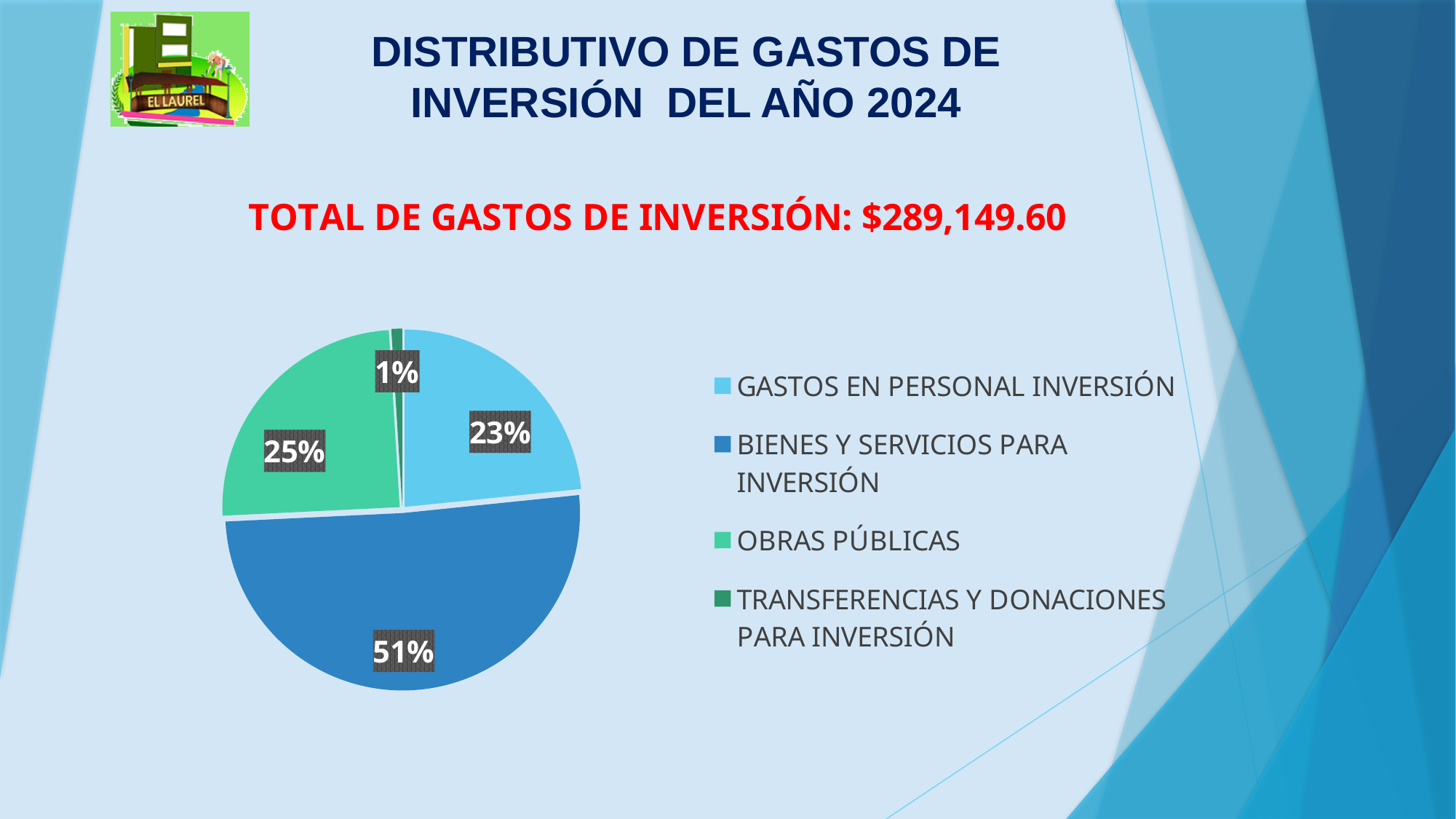
What is the difference in percentage points between BIENES Y SERVICIOS PARA INVERSIÓN and OBRAS PÚBLICAS? 26 Which category has the smallest slice of the pie? TRANSFERENCIAS Y DONACIONES PARA INVERSIÓN What share of the pie does TRANSFERENCIAS Y DONACIONES PARA INVERSIÓN represent? 1% Which legend entry is shown in dark green? TRANSFERENCIAS Y DONACIONES PARA INVERSIÓN What share of the pie does OBRAS PÚBLICAS represent? 25% What kind of chart is shown on the slide? pie chart What share of the pie does GASTOS EN PERSONAL INVERSIÓN represent? 23% Which is larger, the slice for OBRAS PÚBLICAS or the slice for GASTOS EN PERSONAL INVERSIÓN? OBRAS PÚBLICAS Which category has the largest slice of the pie? BIENES Y SERVICIOS PARA INVERSIÓN How many categories does the pie chart show? 4 What total amount of investment expenses is stated on the slide? $289,149.60